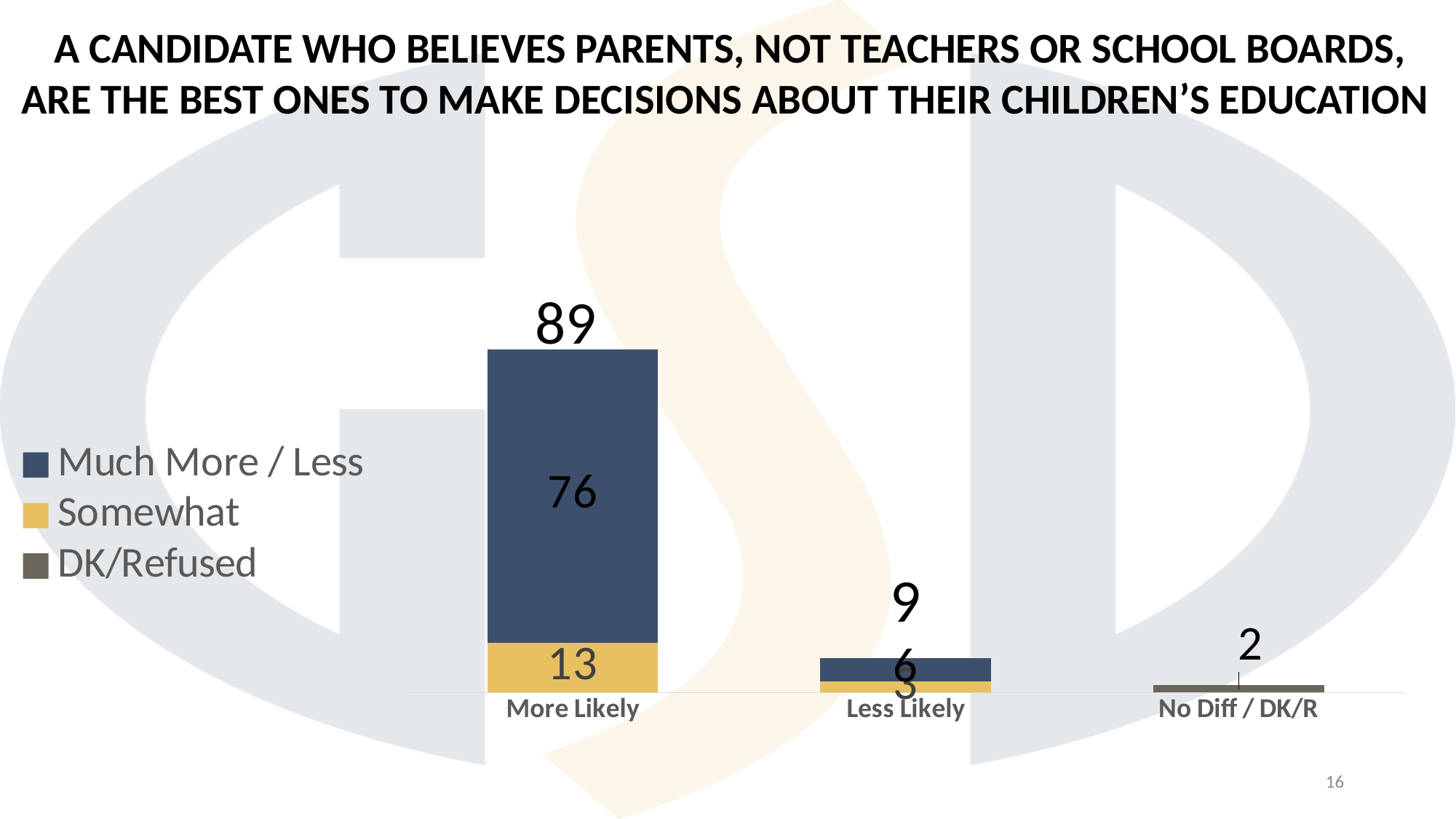
Which category has the lowest total? No Diff / DK/R What is the Much More / Less value for Less Likely? 6 Which category has the highest total? More Likely How many series does the legend list? 3 How many categories are shown on the x axis? 3 What is the difference between the More Likely total and the Less Likely total? 80 What is the Somewhat value for Less Likely? 3 What is the value shown for No Diff / DK/R? 2 What is the Much More / Less value for More Likely? 76 What is the Somewhat value for More Likely? 13 What is the total of the stacked bar for Less Likely? 9 What is the total of the stacked bar for More Likely? 89